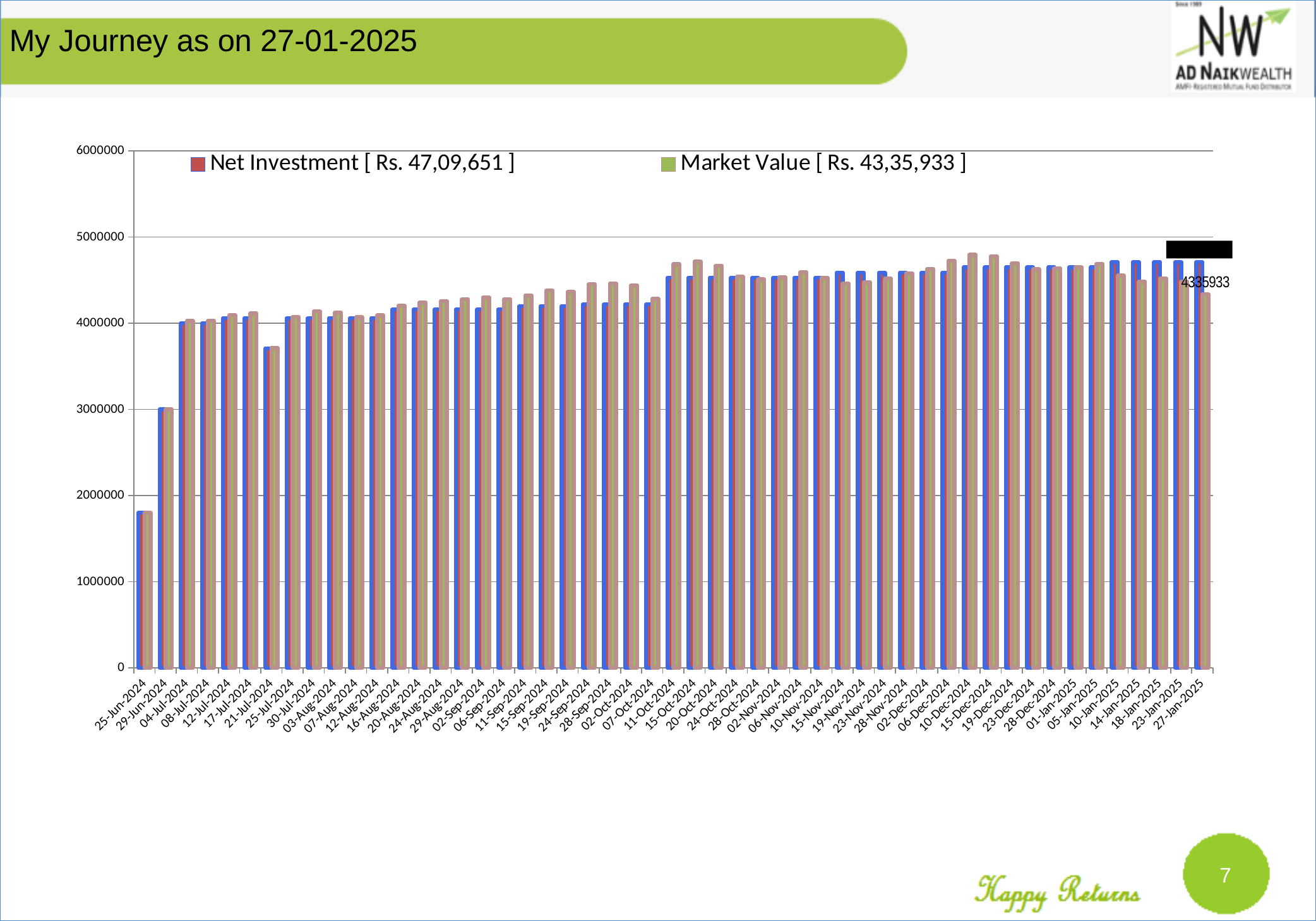
Is the Net Investment on 27-Jan-2025 greater or less than 5000000? less How many series does the chart legend list? 2 What total amount is shown in the legend entry for Net Investment? Rs. 47,09,651 What is the Market Value on 27-Jan-2025 according to the data label? 4335933 Does the Net Investment generally rise or fall from 25-Jun-2024 to 27-Jan-2025? rise Which date has the lowest Net Investment? 25-Jun-2024 Is the Net Investment on 25-Jun-2024 greater or less than 2000000? less Is the Market Value on 15-Oct-2024 greater or less than 4000000? greater What kind of chart is shown on the slide? bar chart On 27-Jan-2025, which is larger: Net Investment or Market Value? Net Investment Which date has the lowest Market Value? 25-Jun-2024